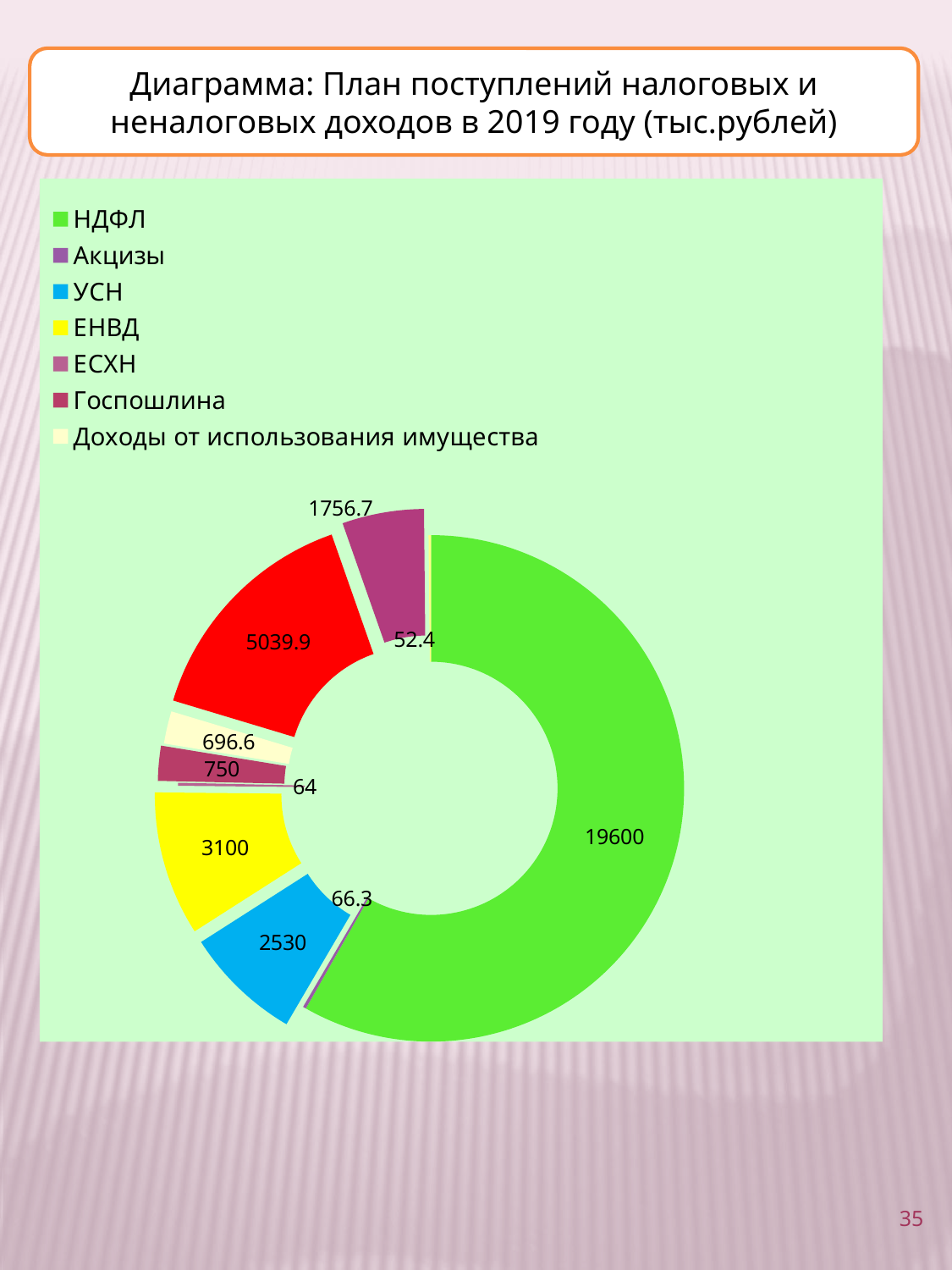
How many entries does the legend list? 7 What is the value for Акцизы? 66.3 What is the value for Доходы от использования имущества? 696.6 What is the value for ЕНВД? 3100 What is the value for НДФЛ? 19600 What is the value for Госпошлина? 750 What kind of chart is shown on the slide? doughnut chart What colour is the НДФЛ slice? green Which is larger, ЕНВД or УСН? ЕНВД What is the difference between the values for ЕНВД and УСН? 570 What is the value for УСН? 2530 Which legend category has the largest slice? НДФЛ